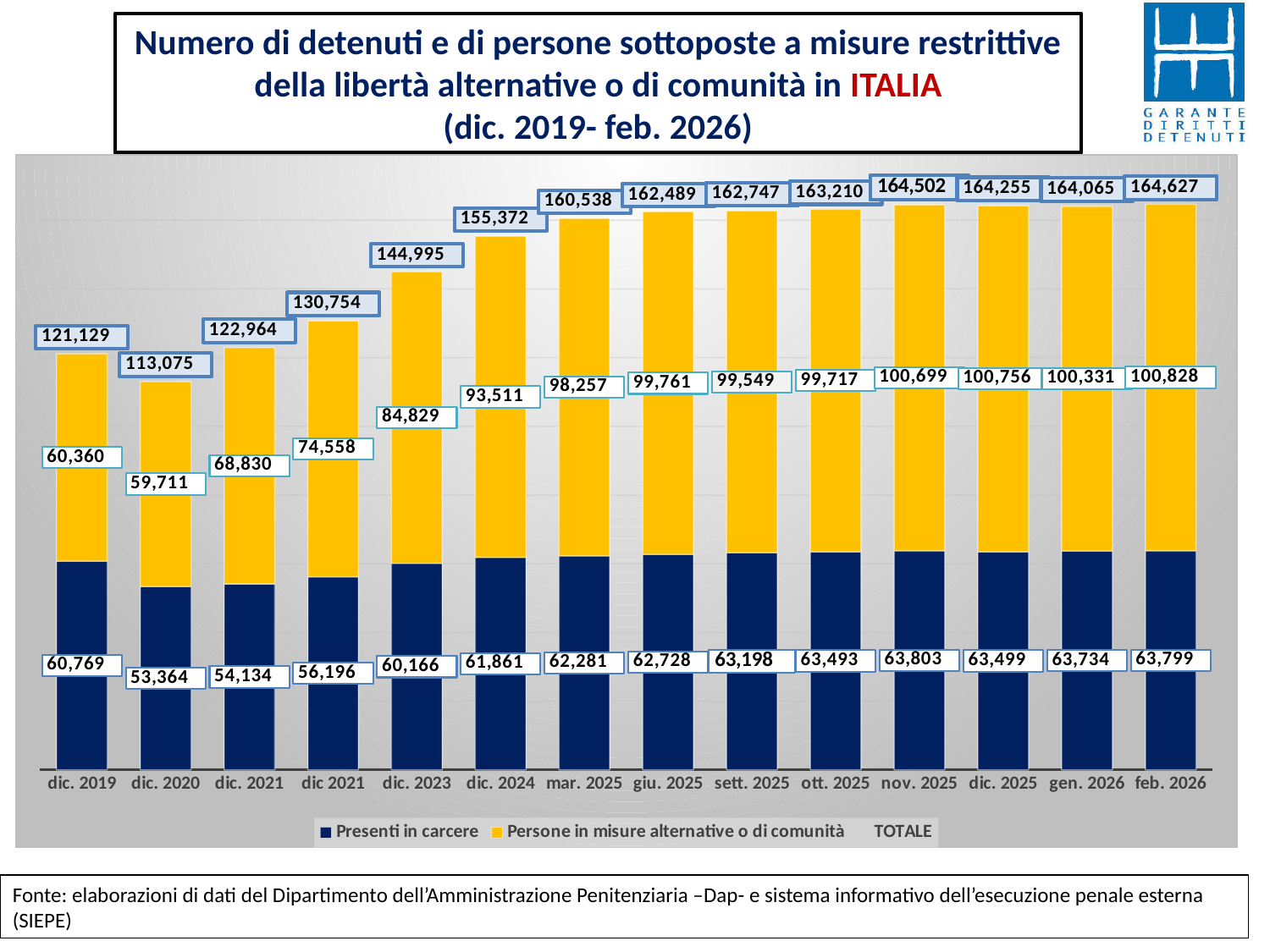
Which period has the lowest value for 'Presenti in carcere'? dic. 2020 Which is larger, 'Presenti in carcere' in dic. 2023 or in dic. 2024? dic. 2024 What is the value for 'Persone in misure alternative o di comunità' in feb. 2026? 100,828 What is the TOTALE value shown for dic. 2024? 155,372 What is the difference between the TOTALE for feb. 2026 and the TOTALE for dic. 2019? 43,498 How many entries does the chart legend list? 3 What is the total of the stacked bar for dic. 2020? 113,075 Which period has the highest TOTALE value? feb. 2026 How many people are shown as 'Presenti in carcere' for dic. 2019? 60,769 How many periods are shown on the x axis of the chart? 14 What kind of chart is shown on the slide? Stacked bar chart In feb. 2026, how much larger is 'Persone in misure alternative o di comunità' than 'Presenti in carcere'? 37,029